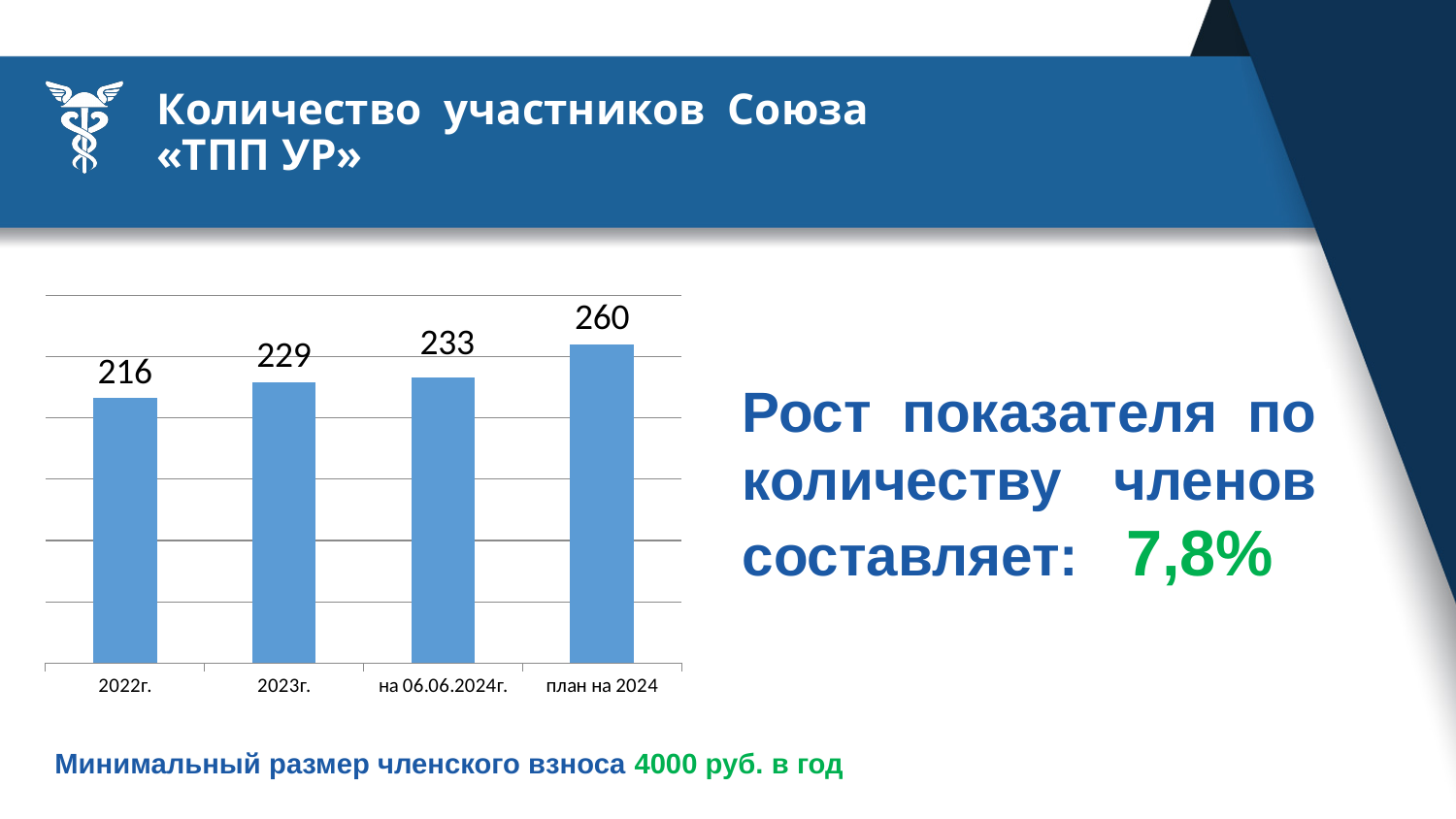
What is the difference between the values for план на 2024 and 2022г.? 44 Which category has the highest value? план на 2024 What kind of chart is shown on the slide? bar chart What is the value for 2023г.? 229 What is the value for на 06.06.2024г.? 233 What is the difference between the values for 2023г. and 2022г.? 13 Do the values rise or fall from left to right along the x axis? rise Which is larger, the value for 2023г. or the value for на 06.06.2024г.? на 06.06.2024г. What is the value for 2022г.? 216 Which category has the lowest value? 2022г. What is the value for план на 2024? 260 How many categories are shown on the x axis? 4